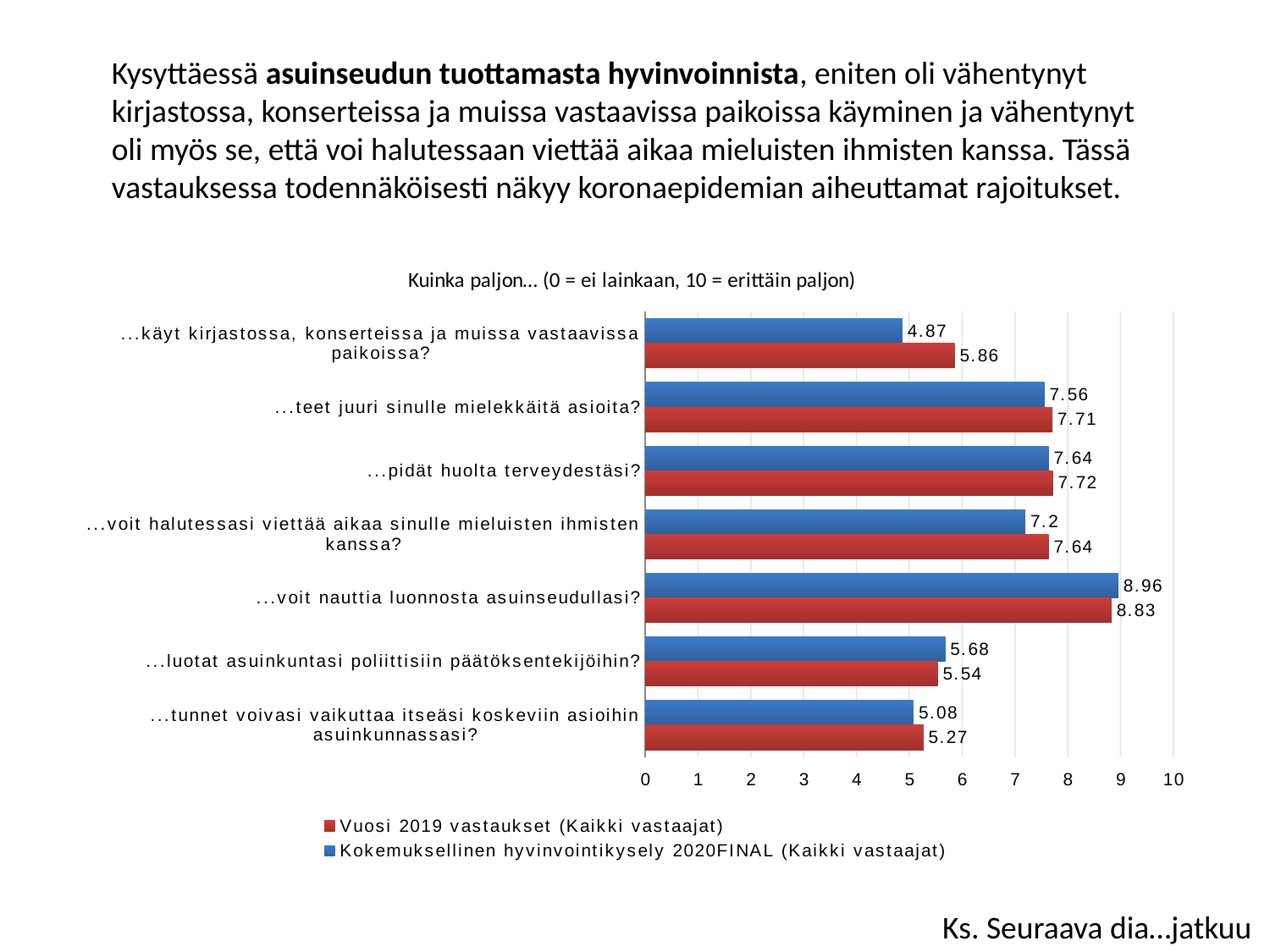
What is the Vuosi 2019 value for "...luotat asuinkuntasi poliittisiin päätöksentekijöihin?"? 5.54 What is the 2020 (Kokemuksellinen hyvinvointikysely 2020FINAL) value for "...käyt kirjastossa, konserteissa ja muissa vastaavissa paikoissa?"? 4.87 Which category has the lowest Vuosi 2019 value? ...tunnet voivasi vaikuttaa itseäsi koskeviin asioihin asuinkunnassasi? What kind of chart is shown on the slide? Bar chart What is the Vuosi 2019 value for "...voit halutessasi viettää aikaa sinulle mieluisten ihmisten kanssa?"? 7.64 How many categories (questions) are shown in the chart? 7 What is the difference between the 2020 and Vuosi 2019 values for "...voit nauttia luonnosta asuinseudullasi?"? 0.13 How many series does the legend list? 2 What is the difference between the Vuosi 2019 and 2020 values for "...käyt kirjastossa, konserteissa ja muissa vastaavissa paikoissa?"? 0.99 Is the 2020 value for "...voit nauttia luonnosta asuinseudullasi?" greater or less than 8? greater Which category has the highest 2020 (Kokemuksellinen hyvinvointikysely 2020FINAL) value? ...voit nauttia luonnosta asuinseudullasi? For "...voit halutessasi viettää aikaa sinulle mieluisten ihmisten kanssa?", which series has the larger value, Vuosi 2019 or 2020? Vuosi 2019